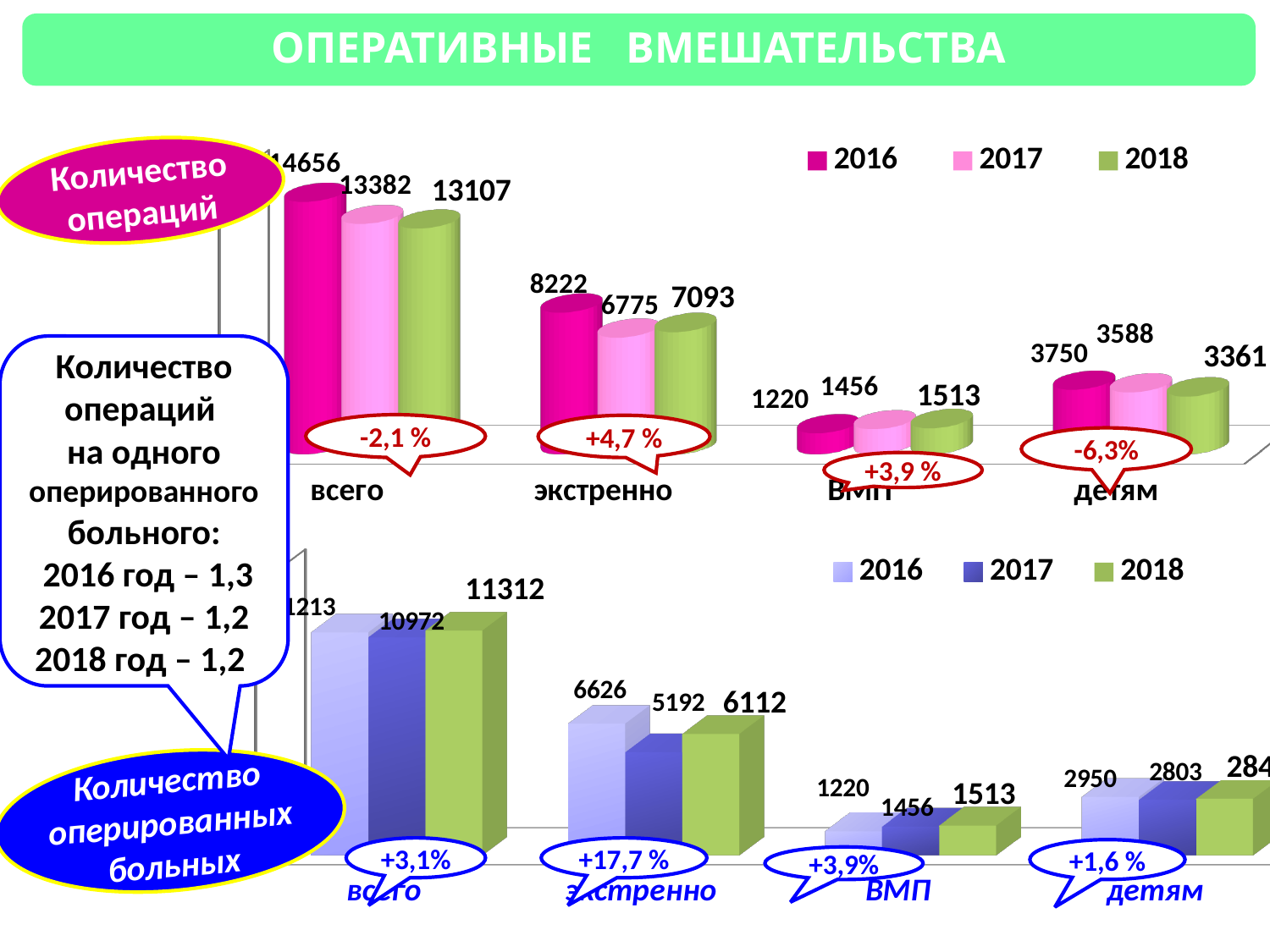
How many series does the legend of the bottom chart list? 3 In the top chart (Количество операций), which category has the lowest values? ВМП In the top chart (Количество операций), what is the value for 2016 in the category 'экстренно'? 8222 In the top chart (Количество операций), which year has the highest value in the category 'ВМП'? 2018 In the top chart (Количество операций), what is the difference between the 2016 and 2018 values for 'всего'? 1549 In the bottom chart (Количество оперированных больных), what is the value for 2017 in the category 'экстренно'? 5192 In the bottom chart (Количество оперированных больных), what is the difference between the 2016 and 2017 values for 'детям'? 147 In the top chart (Количество операций), what is the value for 2018 in the category 'детям'? 3361 In the top chart (Количество операций), which is larger for 'экстренно': the 2017 value or the 2018 value? 2018 In the top chart (Количество операций), what is the value for 2017 in the category 'всего'? 13382 What kind of chart is the top chart (Количество операций)? Bar chart In the bottom chart (Количество оперированных больных), what is the value for 2018 in the category 'всего'? 11312